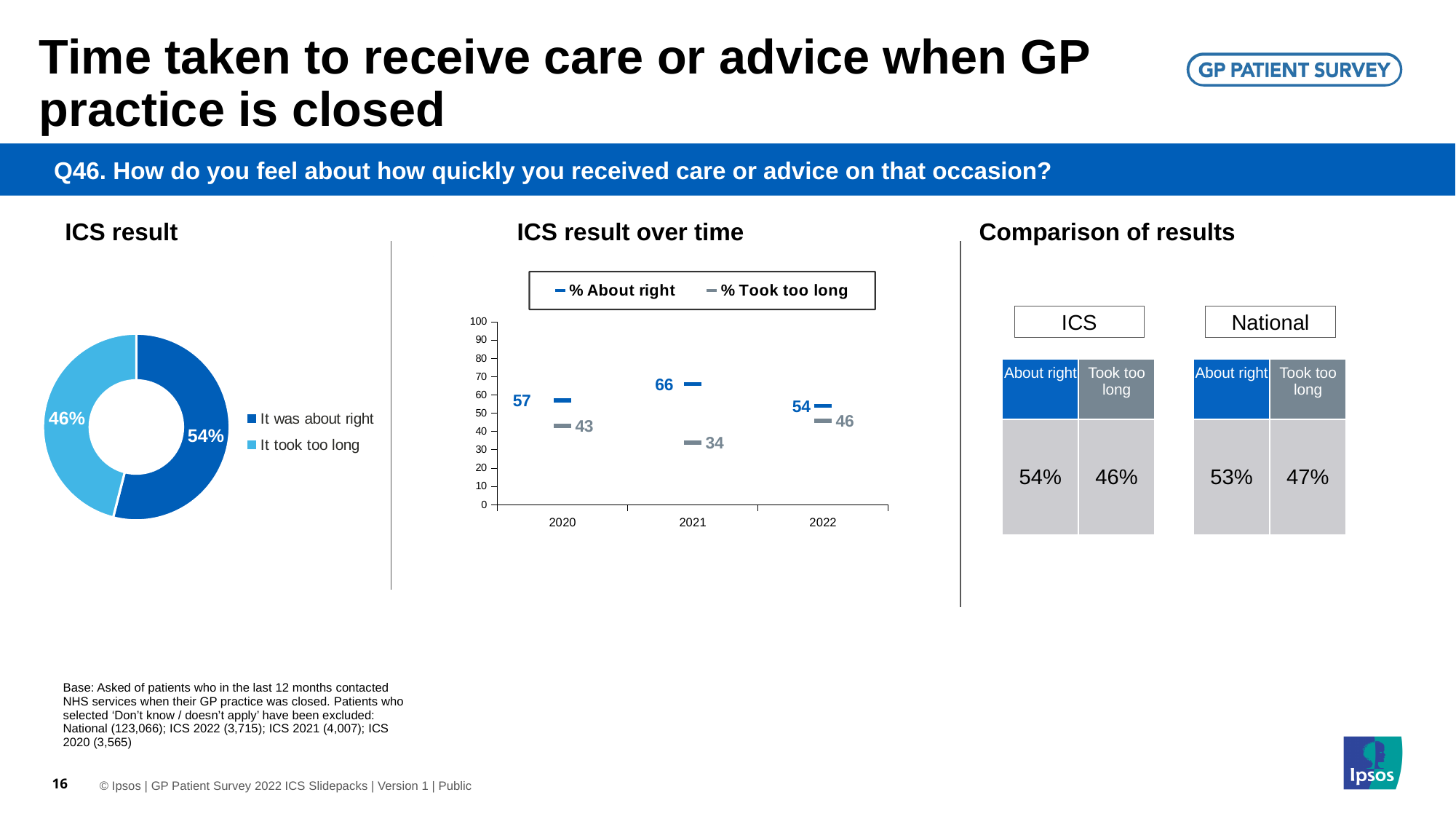
What kind of chart is the 'ICS result' chart? Doughnut chart In the 'ICS result over time' chart, what is the value for '% Took too long' in 2020? 43 How many series does the legend of the 'ICS result over time' chart list? 2 In the 'ICS result' chart, what percentage of patients said it was about right? 54% In the 'ICS result over time' chart, which year has the lowest value for '% Took too long'? 2021 In the 'ICS result over time' chart, how many years are plotted on the x axis? 3 In the 'ICS result over time' chart, what is the difference between '% About right' and '% Took too long' in 2022? 8 In the 'ICS result' chart, what percentage of patients said it took too long? 46% In the 'ICS result over time' chart, which year has the highest value for '% About right'? 2021 In the 'ICS result over time' chart, what is the value for '% About right' in 2021? 66 In the 'Comparison of results' section, which is larger: the ICS 'About right' value or the National 'About right' value? ICS (54%) In the 'ICS result over time' chart, did '% About right' rise or fall from 2021 to 2022? Fall